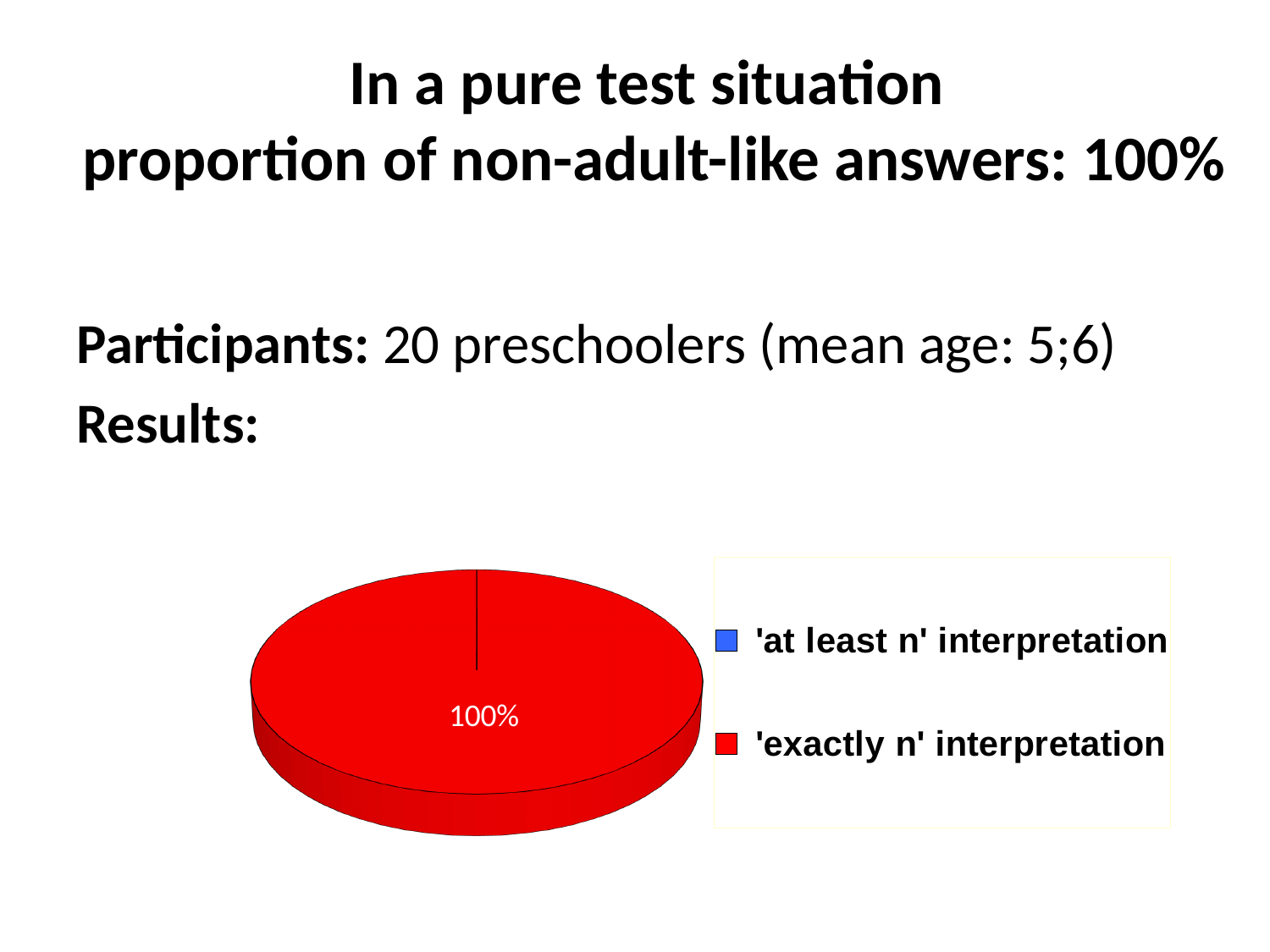
What share of the pie does the 'exactly n' interpretation take? 100% What colour represents the 'at least n' interpretation in the legend? blue Which is larger, the share for the 'exactly n' interpretation or the 'at least n' interpretation? 'exactly n' interpretation What is the data label printed on the pie slice? 100% What kind of chart is shown on the slide? pie chart What colour represents the 'exactly n' interpretation in the legend? red How many entries does the legend list? 2 Which interpretation takes the largest share of the pie? 'exactly n' interpretation Which interpretation takes the smallest share of the pie? 'at least n' interpretation